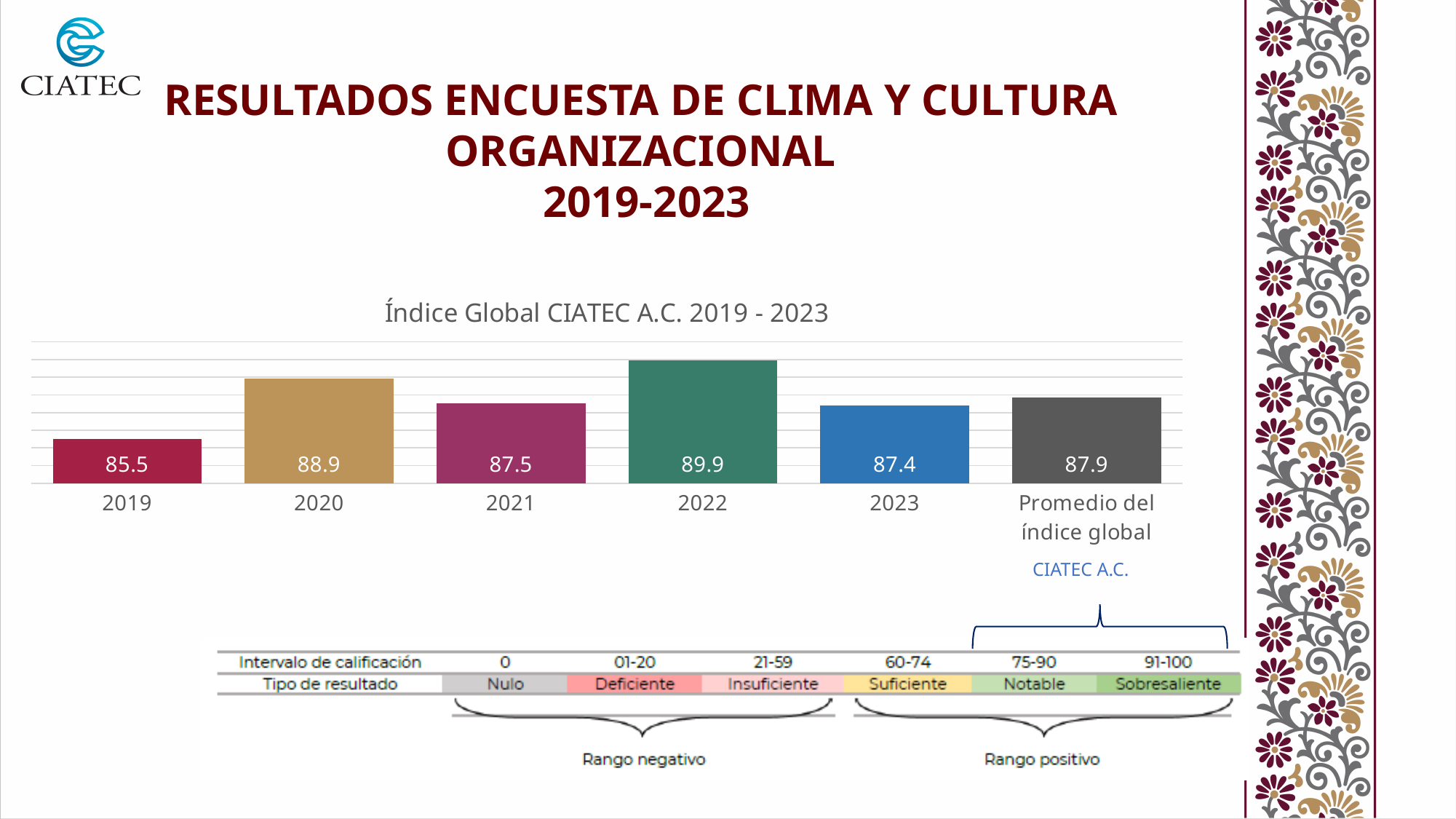
What is the difference between the values for 2020 and 2021? 1.4 Which is larger, the value for 2020 or the value for 2023? 2020 What kind of chart is the Índice Global CIATEC A.C. 2019 - 2023 chart? bar chart Did the value rise or fall from 2022 to 2023? fall What is the value for 2019 in the Índice Global CIATEC A.C. 2019 - 2023 chart? 85.5 What is the difference between the values for 2022 and 2019? 4.4 How many bars are plotted in the Índice Global chart? 6 What is the value shown for 'Promedio del índice global'? 87.9 What is the title of the chart on the slide? Índice Global CIATEC A.C. 2019 - 2023 Which year has the highest value in the Índice Global chart? 2022 What is the value for 2022 in the Índice Global chart? 89.9 Which year has the lowest value in the Índice Global chart? 2019